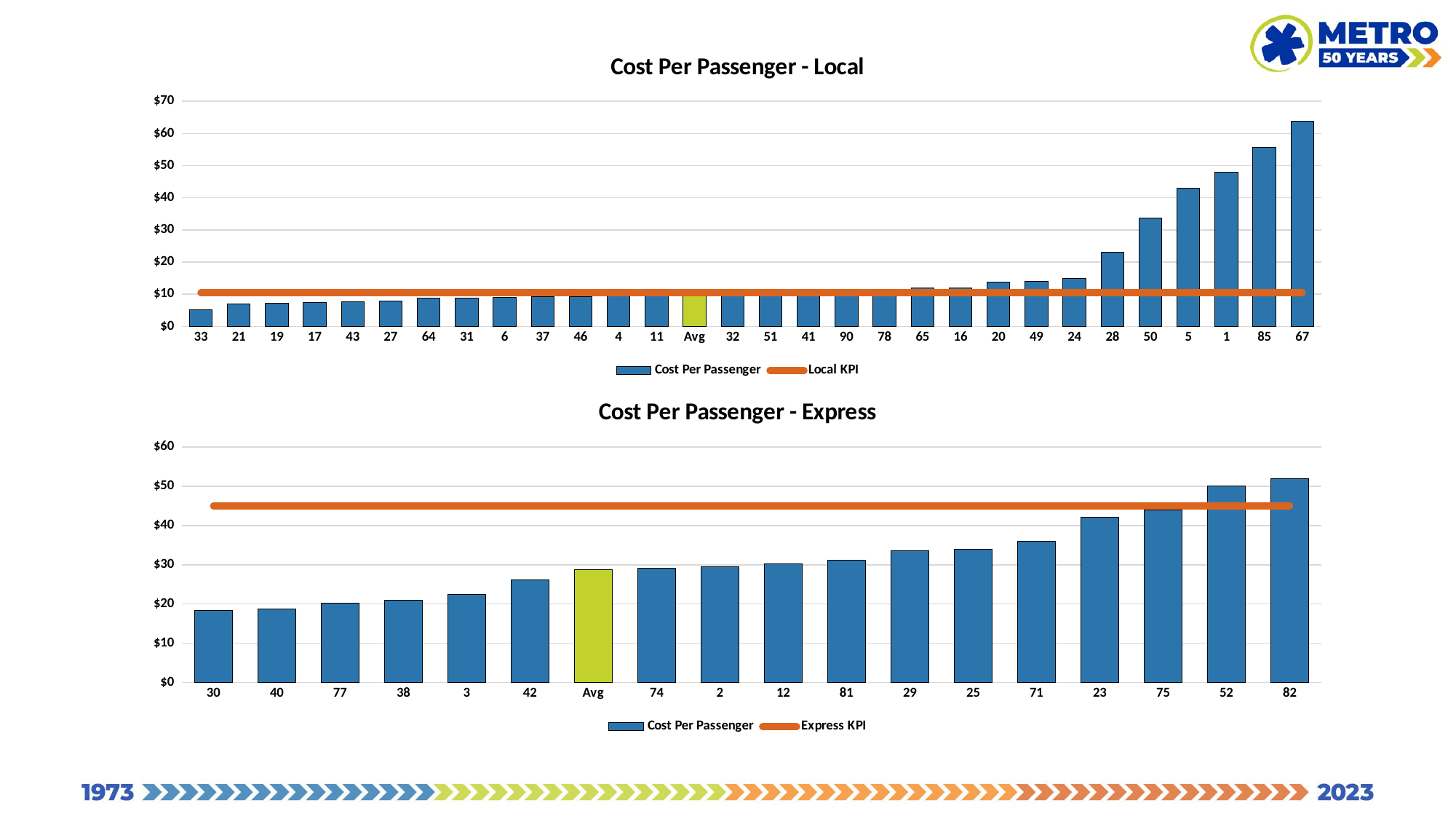
In the 'Cost Per Passenger - Local' chart, how many bars are plotted along the x axis (including Avg)? 30 In the 'Cost Per Passenger - Local' chart, is the value for route 67 greater or less than $60? greater In the 'Cost Per Passenger - Express' chart, how many series does the legend list? 2 In the 'Cost Per Passenger - Express' chart, which route has the lowest cost per passenger? 30 In the 'Cost Per Passenger - Local' chart, which route has the highest cost per passenger? 67 In the 'Cost Per Passenger - Express' chart, how many bars are plotted along the x axis (including Avg)? 18 In the 'Cost Per Passenger - Express' chart, which route has the highest cost per passenger? 82 In the 'Cost Per Passenger - Express' chart, which is larger, the value for route 23 or the value for route 3? 23 In the 'Cost Per Passenger - Local' chart, which route has the lowest cost per passenger? 33 In the 'Cost Per Passenger - Express' chart, is the value for route 30 greater or less than $20? less In the 'Cost Per Passenger - Local' chart, is the value for route 33 greater or less than $10? less